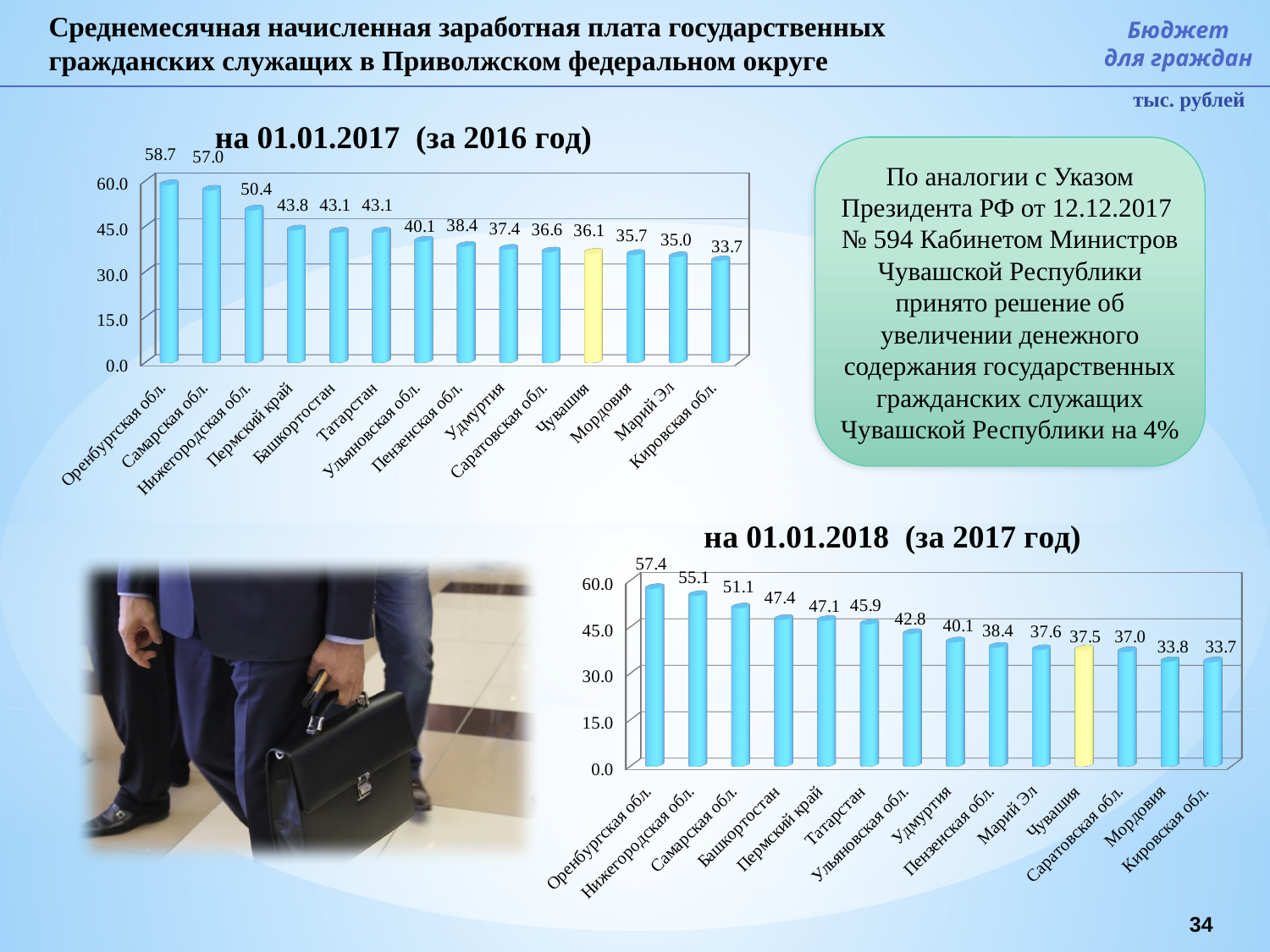
On the chart 'на 01.01.2017 (за 2016 год)', which is larger: Пермский край or Ульяновская обл.? Пермский край On the chart 'на 01.01.2017 (за 2016 год)', what is the value for Кировская обл.? 33.7 On the chart 'на 01.01.2017 (за 2016 год)', what is the value for Чувашия? 36.1 What type of chart is 'на 01.01.2018 (за 2017 год)'? bar chart On the chart 'на 01.01.2017 (за 2016 год)', which region has the highest value? Оренбургская обл. On the chart 'на 01.01.2018 (за 2017 год)', what is the value for Чувашия? 37.5 On the chart 'на 01.01.2018 (за 2017 год)', is the value for Башкортостан greater or less than 45.0? greater On the chart 'на 01.01.2018 (за 2017 год)', which bar is highlighted in yellow? Чувашия How many regions are shown on the chart 'на 01.01.2017 (за 2016 год)'? 14 On the chart 'на 01.01.2018 (за 2017 год)', which region has the lowest value? Кировская обл. On the chart 'на 01.01.2018 (за 2017 год)', do the values rise or fall from left to right? fall On the chart 'на 01.01.2018 (за 2017 год)', what is the difference between Оренбургская обл. and Нижегородская обл.? 2.3